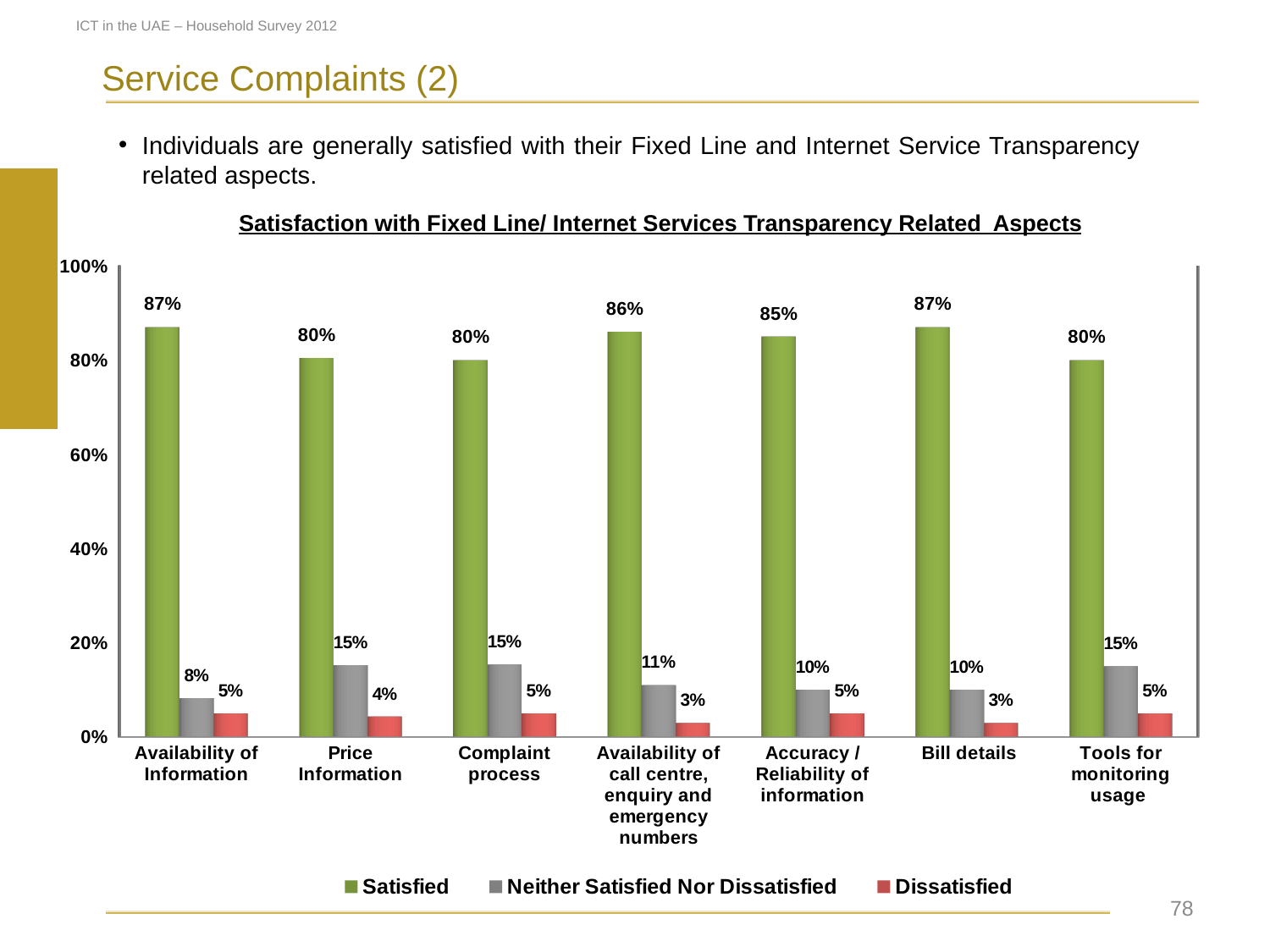
What type of chart is shown on the slide? Bar chart Which categories have the lowest Dissatisfied value? Availability of call centre, enquiry and emergency numbers and Bill details (3%) Which is larger: the Satisfied value for Accuracy / Reliability of information or for Tools for monitoring usage? Accuracy / Reliability of information Which category has the highest Neither Satisfied Nor Dissatisfied value? Price Information, Complaint process and Tools for monitoring usage (15%) What is the title of the chart? Satisfaction with Fixed Line/ Internet Services Transparency Related Aspects What percentage of individuals are satisfied with Bill details? 87% How many series does the legend list? 3 What is the Dissatisfied value for Price Information? 4% What is the difference between the Satisfied values for Availability of Information and Price Information? 7% How many categories are shown on the x axis? 7 Is the Satisfied value for Complaint process greater or less than 60%? greater What is the Neither Satisfied Nor Dissatisfied value for Availability of call centre, enquiry and emergency numbers? 11%